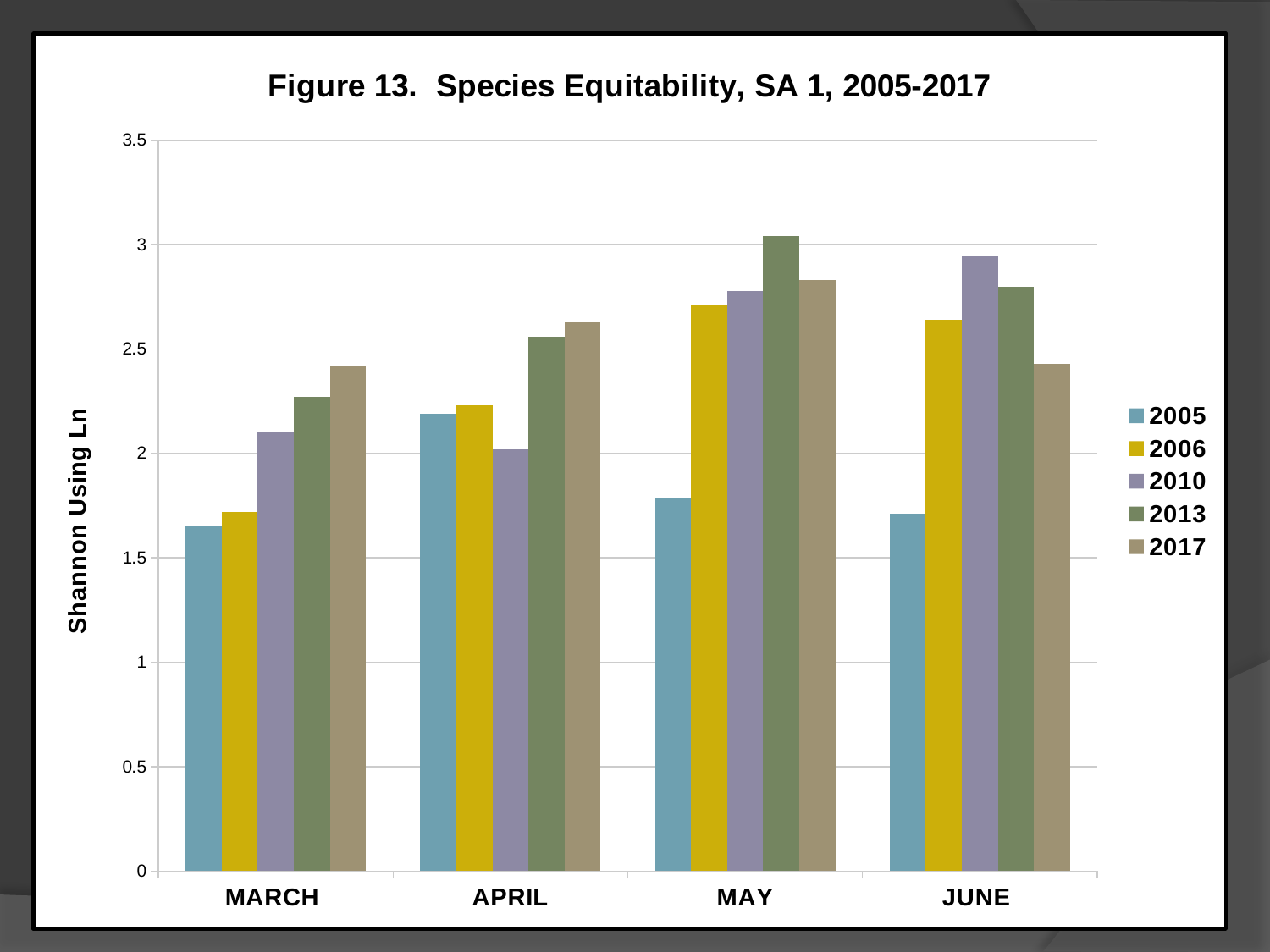
Is the value for 2005 in MARCH greater or less than 2? less How many months are shown on the x axis? 4 What kind of chart is shown on the slide? bar chart In JUNE, which is larger, the value for 2010 or the value for 2017? 2010 Is the value for 2013 in MAY greater or less than 3? greater Is the value for 2010 in APRIL greater or less than 2.5? less What is the title of the y axis? Shannon Using Ln In MARCH, do the values rise or fall going from 2005 to 2017? rise In JUNE, which year has the highest value? 2010 In which month is the 2013 value highest? MAY How many series does the legend list? 5 In MAY, which year has the lowest value? 2005